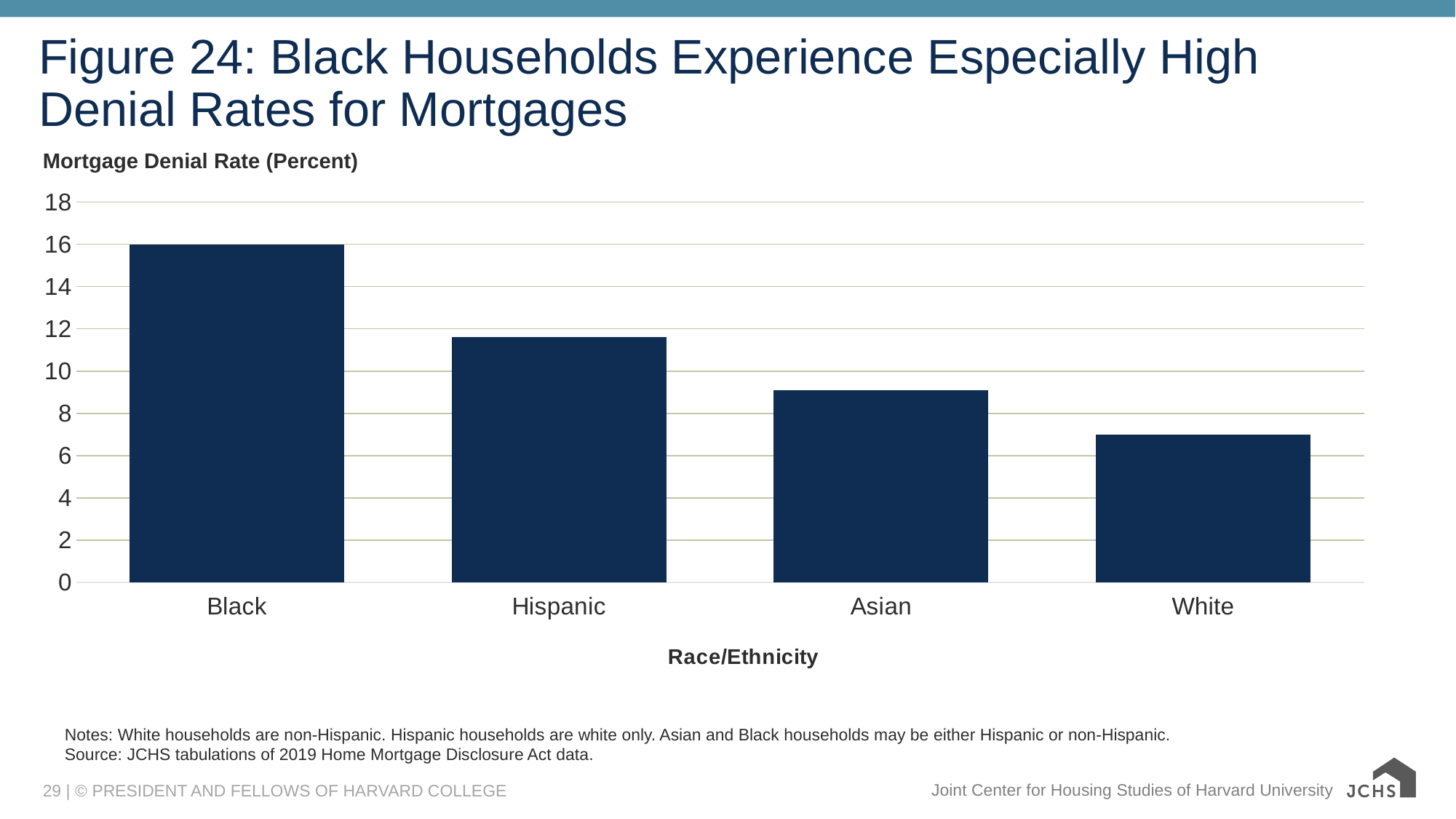
How many race/ethnicity categories are shown in the chart? 4 Is the mortgage denial rate for Hispanic households greater or less than 10? greater Which has a higher mortgage denial rate, Hispanic or Asian households? Hispanic Is the mortgage denial rate for White households greater or less than 8? less What type of chart is shown on the slide? bar chart Which race/ethnicity has the highest mortgage denial rate? Black Is the mortgage denial rate for Hispanic households greater or less than 12? less Do the mortgage denial rates rise or fall moving from Black to White along the x axis? fall What is the label of the x axis? Race/Ethnicity Which race/ethnicity has the lowest mortgage denial rate? White What is the mortgage denial rate for Black households? 16